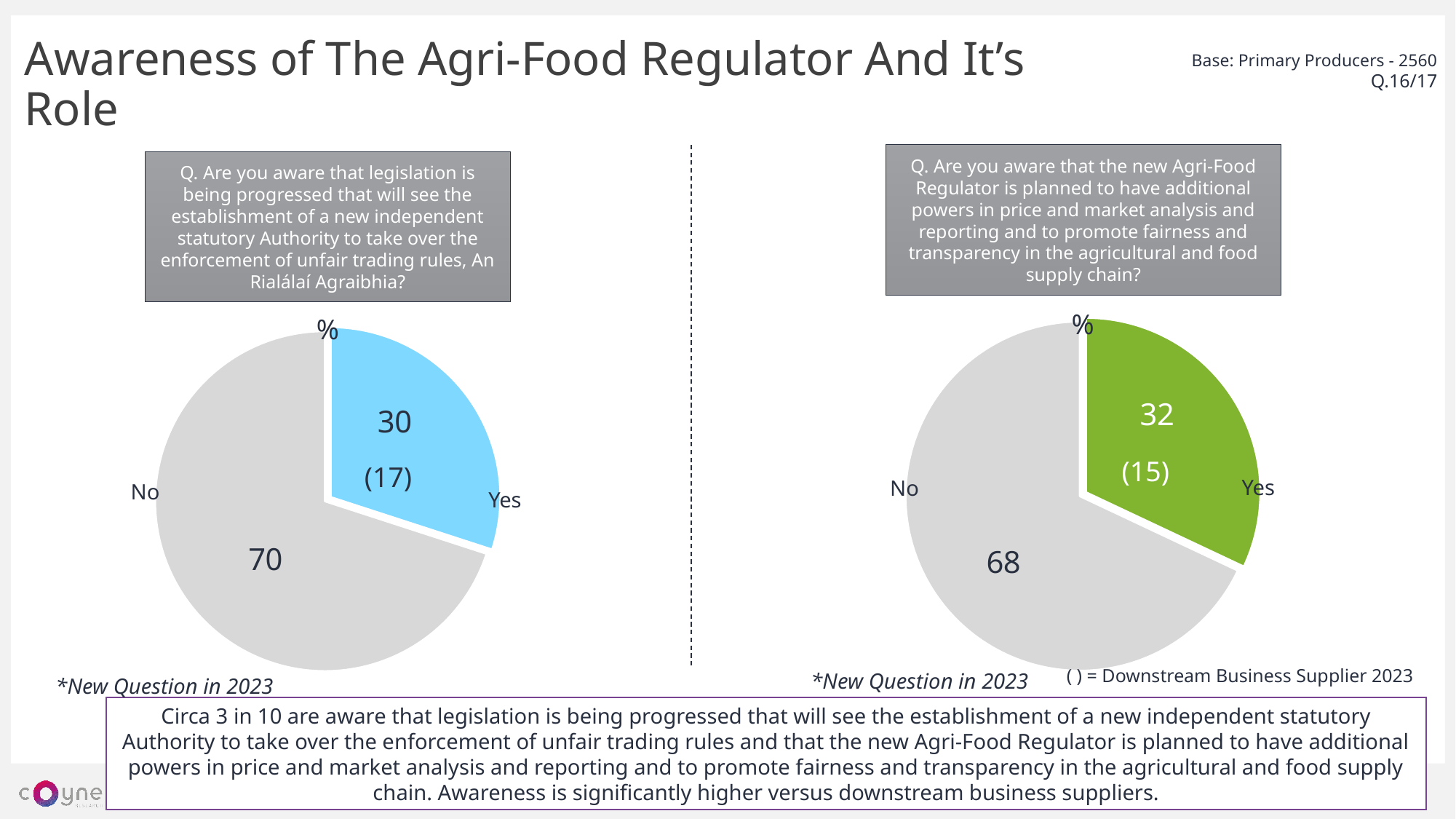
What type of chart is used on the left side of the slide? Pie chart How many slices does the right pie chart have? 2 In the right pie chart, what is the Downstream Business Supplier 2023 value shown in parentheses for Yes? 15 In the left pie chart, which slice is the largest? No In the right pie chart, what is the value for Yes? 32 In the left pie chart, what is the value for Yes? 30 In the right pie chart, what is the value for No? 68 In the left pie chart, what is the value for No? 70 In the left pie chart, what is the Downstream Business Supplier 2023 value shown in parentheses for Yes? 17 In the left pie chart, what is the difference between the No and Yes values? 40 In the right pie chart, which slice is the smallest? Yes Is the Yes value larger in the left pie chart or the right pie chart? Right pie chart